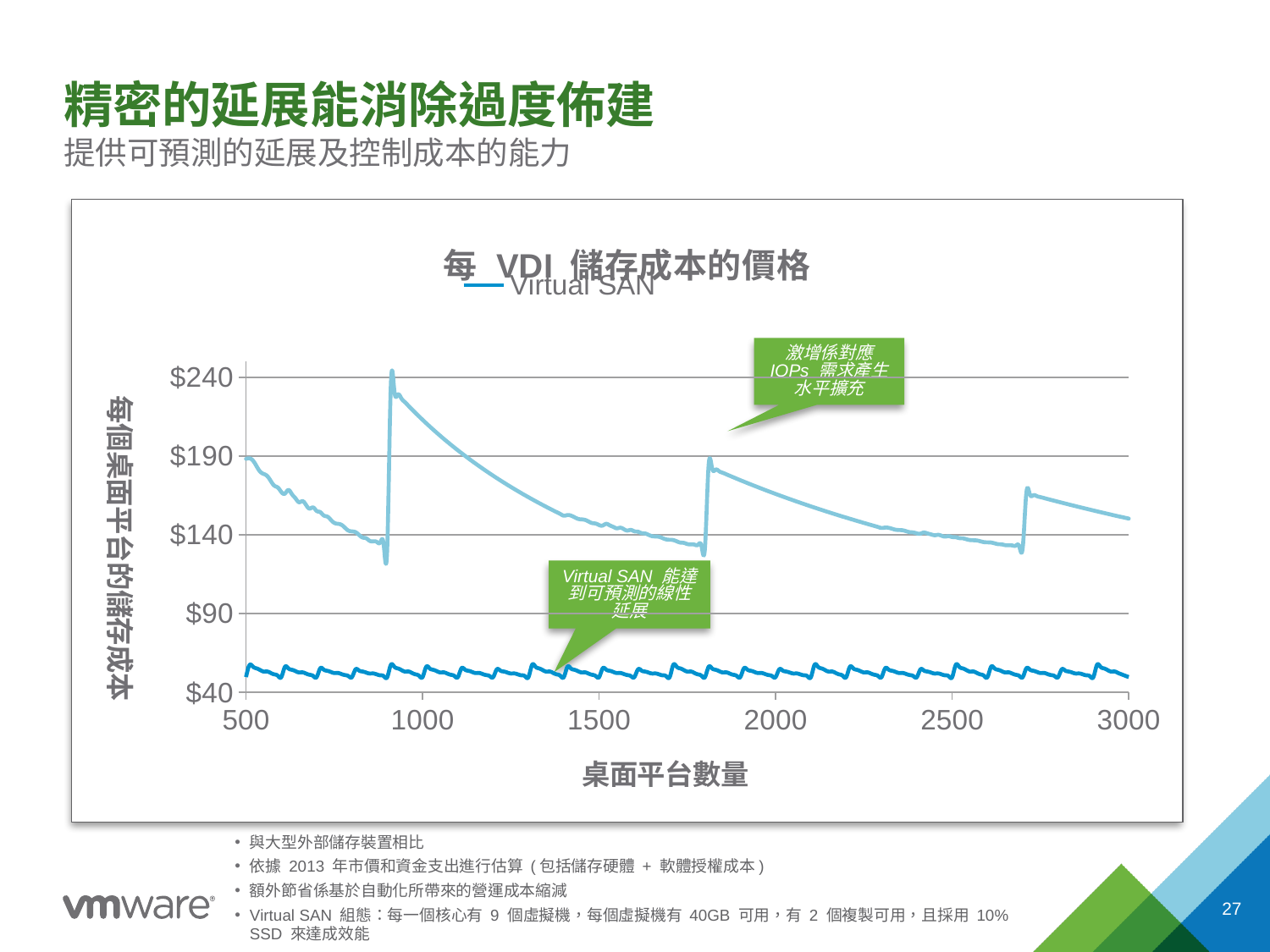
Is the Virtual SAN value at 3000 desktops greater or less than $90? less What kind of chart is shown on the slide? line chart What is the title of the chart? 每 VDI 儲存成本的價格 How many tick labels are shown on the x axis? 6 What is the label of the x axis? 桌面平台數量 Is the Virtual SAN value at 500 desktops greater or less than $90? less Is the value of the light blue line at 2000 desktops greater or less than $140? greater Which series name is shown in the chart legend? Virtual SAN Which series has the lowest values across the whole x axis range? Virtual SAN At 1500 desktops, which line is higher: the Virtual SAN line or the light blue line? the light blue line